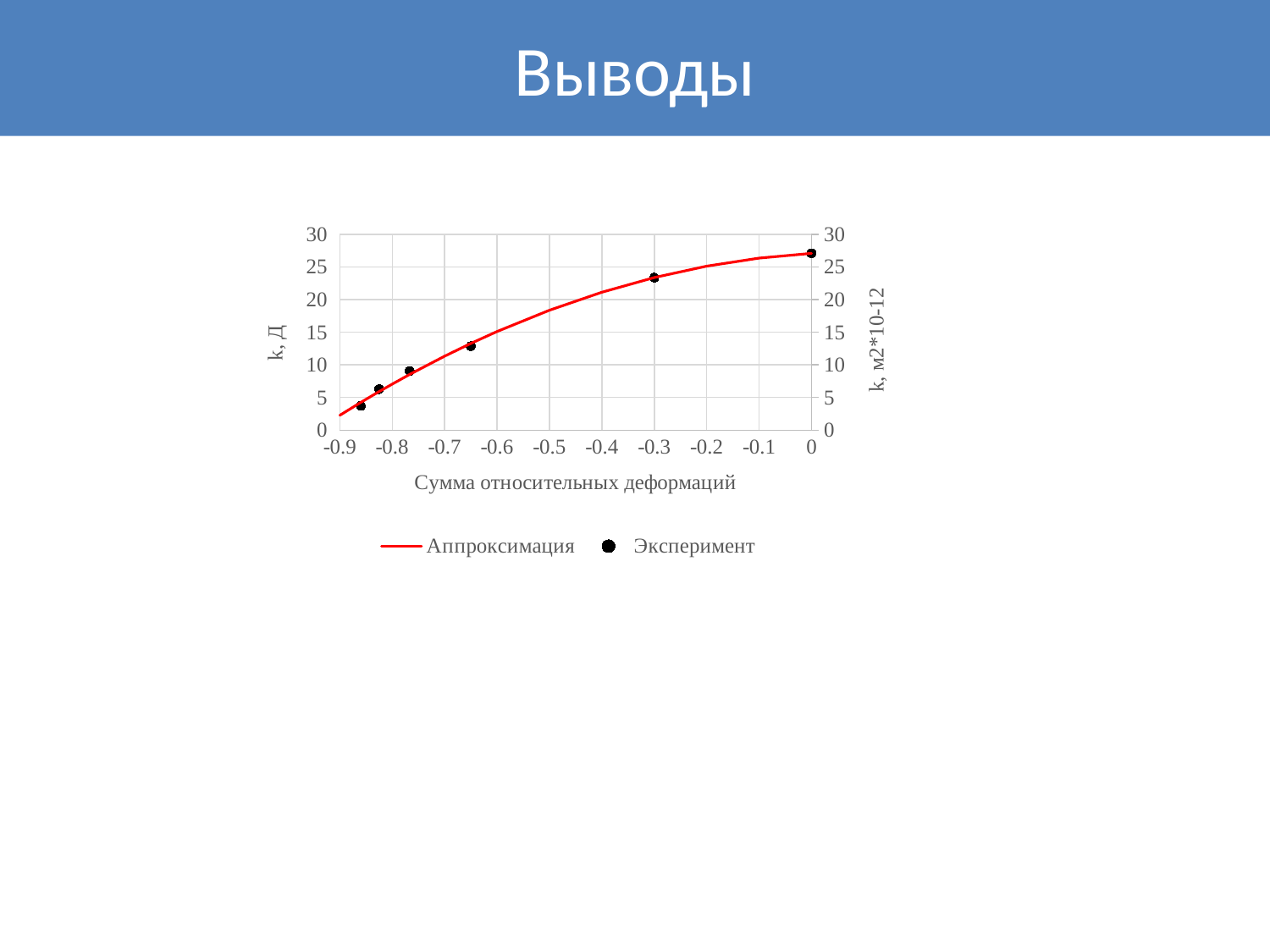
Do the values rise or fall as the x axis goes from -0.9 to 0? rise Is the leftmost Эксперимент point greater or less than 5? less Which Эксперимент point has the highest value: the one at x = 0 or the one at x = -0.3? the one at x = 0 Is the Эксперимент value at x = -0.3 greater or less than 20? greater How many series does the legend list? 2 What is the title of the x axis? Сумма относительных деформаций What are the two series named in the legend? Аппроксимация and Эксперимент At which x value does the Эксперимент series reach its highest point? 0 Is the Аппроксимация curve at x = -0.5 greater or less than 15? greater How many experimental data points (Эксперимент) are plotted? 6 What kind of chart is shown on the slide? line chart with scatter points